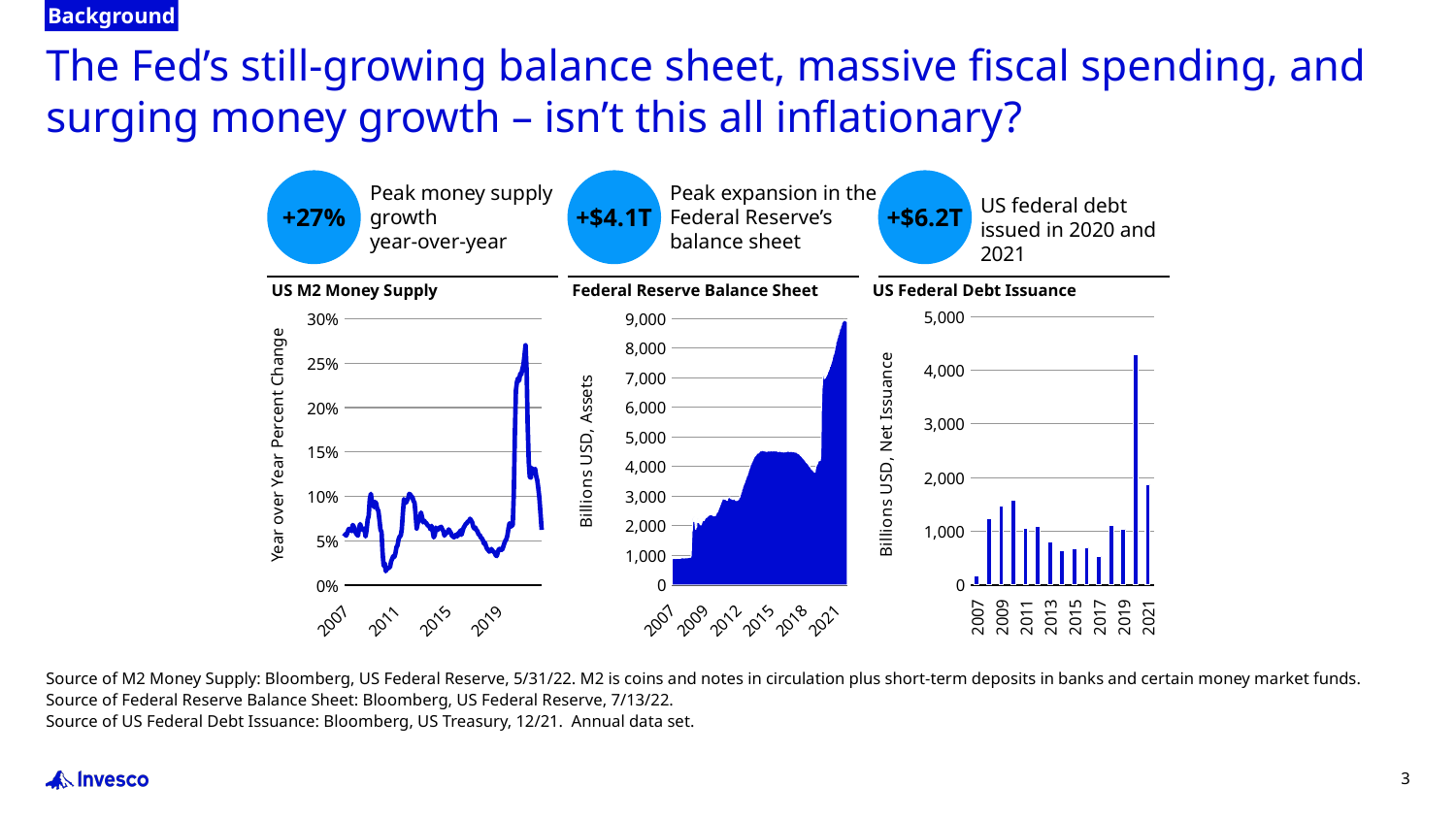
In the US Federal Debt Issuance chart, which year has the highest net issuance? 2020 How many years (bars) are shown in the US Federal Debt Issuance chart? 15 In the US Federal Debt Issuance chart, which year has the larger value, 2020 or 2021? 2020 In the Federal Reserve Balance Sheet chart, is the value at the end of the series in 2021 greater or less than 8,000? greater In the US Federal Debt Issuance chart, is the value for 2021 greater or less than 1,000? greater What kind of chart is the US Federal Debt Issuance chart? bar chart In the US Federal Debt Issuance chart, which year has the lowest net issuance? 2007 In the Federal Reserve Balance Sheet chart, do the values generally rise or fall from 2007 to 2021? rise What is the y-axis label of the Federal Reserve Balance Sheet chart? Billions USD, Assets In the US Federal Debt Issuance chart, is the value for 2020 greater or less than 4,000? greater What kind of chart is the US M2 Money Supply chart? line chart